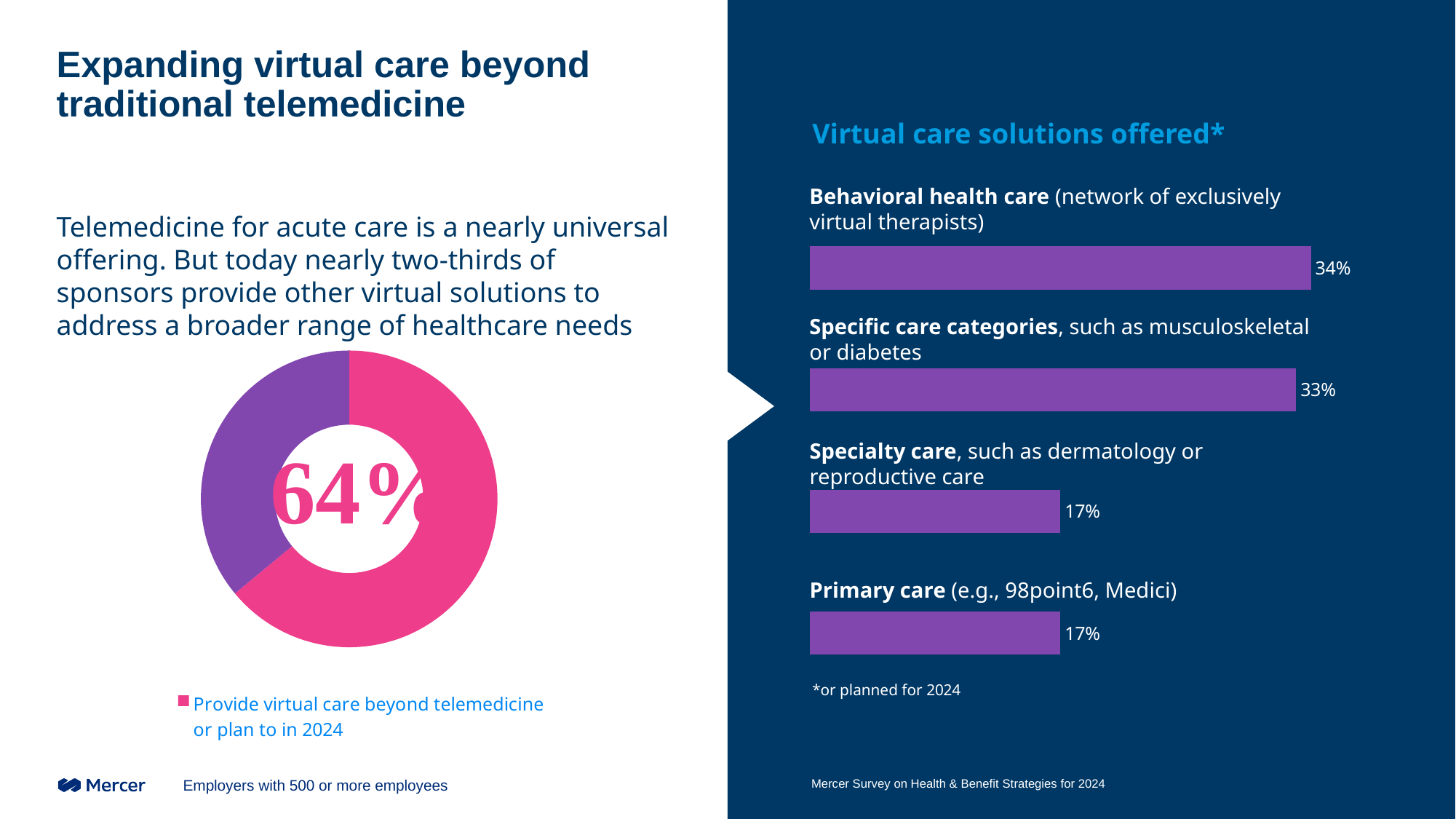
In the 'Virtual care solutions offered*' chart, what is the value for Specific care categories? 33% How many categories are shown in the 'Virtual care solutions offered*' chart? 4 In the 'Virtual care solutions offered*' chart, which category has the highest value? Behavioral health care What kind of chart is shown on the left side of the slide? Donut chart In the 'Virtual care solutions offered*' chart, what is the value for Specialty care? 17% In the donut chart on the left, what share of employers provide virtual care beyond telemedicine or plan to in 2024? 64% What kind of chart is the 'Virtual care solutions offered*' chart? Bar chart In the 'Virtual care solutions offered*' chart, what is the value for Primary care? 17% In the 'Virtual care solutions offered*' chart, what is the difference between Behavioral health care and Specialty care? 17% In the 'Virtual care solutions offered*' chart, what is the value for Behavioral health care? 34% In the 'Virtual care solutions offered*' chart, which is larger: Specific care categories or Primary care? Specific care categories In the 'Virtual care solutions offered*' chart, what is the difference between Behavioral health care and Specific care categories? 1%